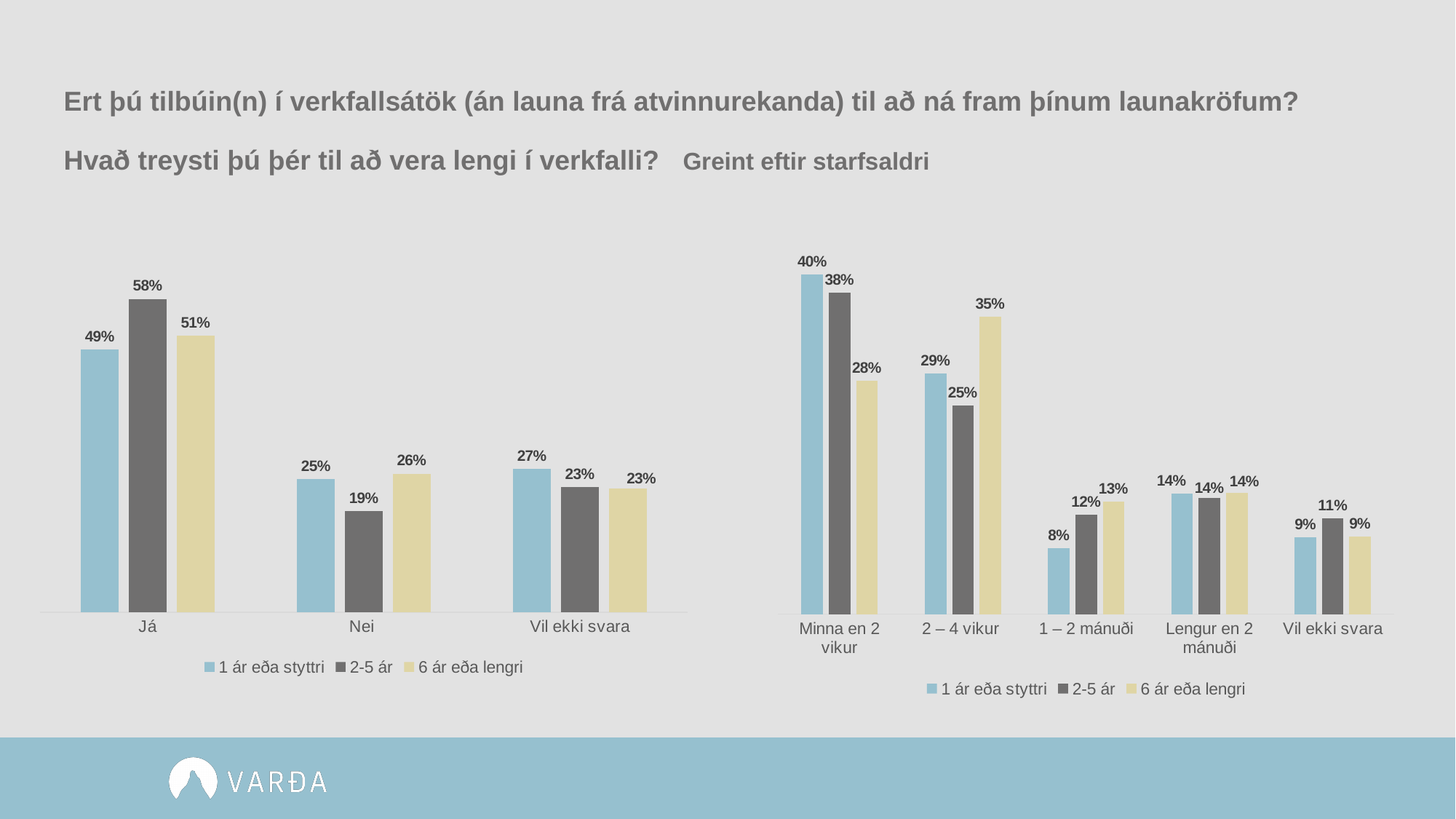
In the right chart, is the '2-5 ár' value for 'Minna en 2 vikur' larger or smaller than the '2-5 ár' value for '2 – 4 vikur'? larger In the right chart, what is the value for '1 ár eða styttri' in the 'Minna en 2 vikur' category? 40% In the left chart, what is the value for '6 ár eða lengri' in the 'Nei' category? 26% What kind of chart is the left chart? bar chart In the left chart, how many categories are shown on the x axis? 3 How many series does the legend of the right chart list? 3 In the right chart, which series has the lowest value in the '1 – 2 mánuði' category? 1 ár eða styttri In the left chart, what is the value for '2-5 ár' in the 'Já' category? 58% In the right chart, what is the value for '6 ár eða lengri' in the '2 – 4 vikur' category? 35% In the right chart, how many categories are shown on the x axis? 5 In the left chart, which series has the highest value in the 'Já' category? 2-5 ár In the left chart, what is the difference between the '1 ár eða styttri' and '2-5 ár' values in the 'Nei' category? 6%